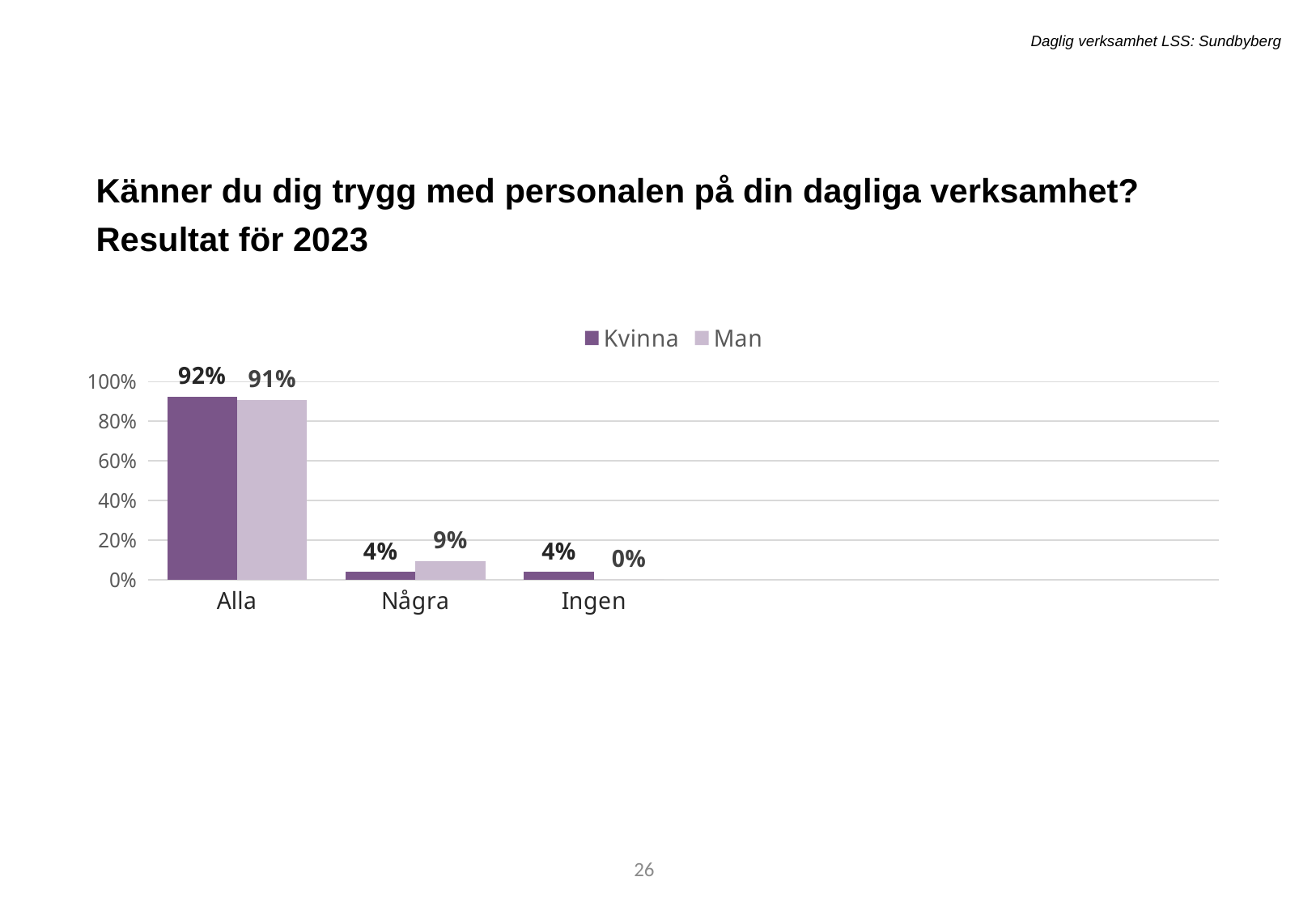
What is the difference between the Kvinna and Man values in the Några category? 5% Which category has the lowest value for Man? Ingen What are the two series named in the legend? Kvinna and Man What is the value for Kvinna in the Alla category? 92% What is the value for Man in the Några category? 9% What kind of chart is shown on the slide? Bar chart What is the value for Kvinna in the Ingen category? 4% What is the value for Man in the Ingen category? 0% How many series does the legend list? 2 Which category has the highest value for Man? Alla Which is larger in the Alla category, Kvinna or Man? Kvinna How many categories are shown on the x axis? 3